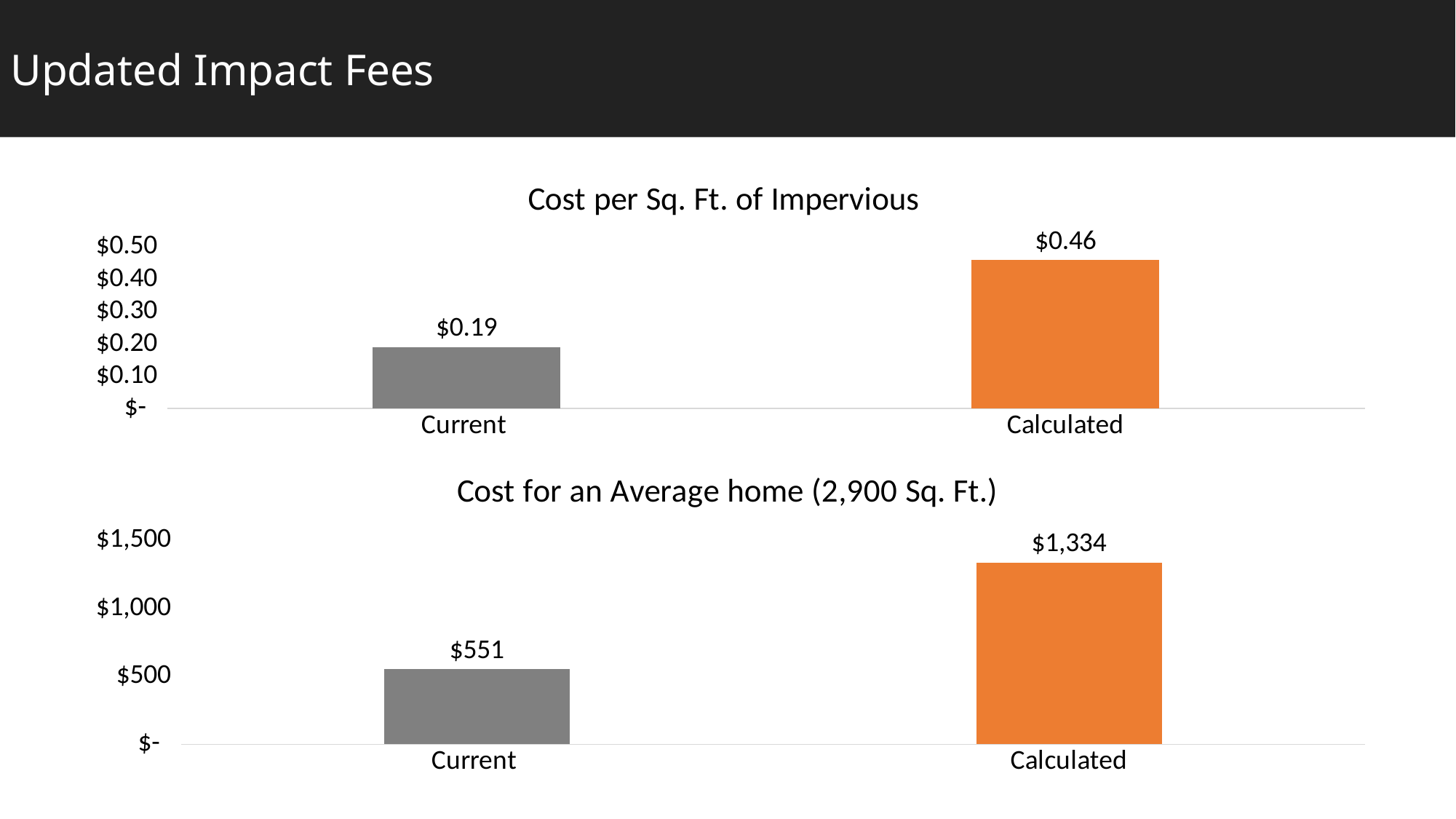
In the 'Cost for an Average home (2,900 Sq. Ft.)' chart, what is the value for Calculated? $1,334 In the 'Cost per Sq. Ft. of Impervious' chart, which category has the highest value? Calculated In the 'Cost per Sq. Ft. of Impervious' chart, what is the value for Current? $0.19 In the 'Cost for an Average home (2,900 Sq. Ft.)' chart, what is the value for Current? $551 How many categories are shown in the 'Cost per Sq. Ft. of Impervious' chart? 2 In the 'Cost for an Average home (2,900 Sq. Ft.)' chart, what is the difference between the Calculated and Current values? $783 In the 'Cost for an Average home (2,900 Sq. Ft.)' chart, is the value for Calculated greater or less than $1,000? greater In the 'Cost for an Average home (2,900 Sq. Ft.)' chart, which category has the lowest value? Current In the 'Cost per Sq. Ft. of Impervious' chart, what colour is the Calculated bar? Orange In the 'Cost per Sq. Ft. of Impervious' chart, what is the value for Calculated? $0.46 In the 'Cost per Sq. Ft. of Impervious' chart, what is the difference between the Calculated and Current values? $0.27 What kind of chart is the 'Cost for an Average home (2,900 Sq. Ft.)' chart? Bar chart